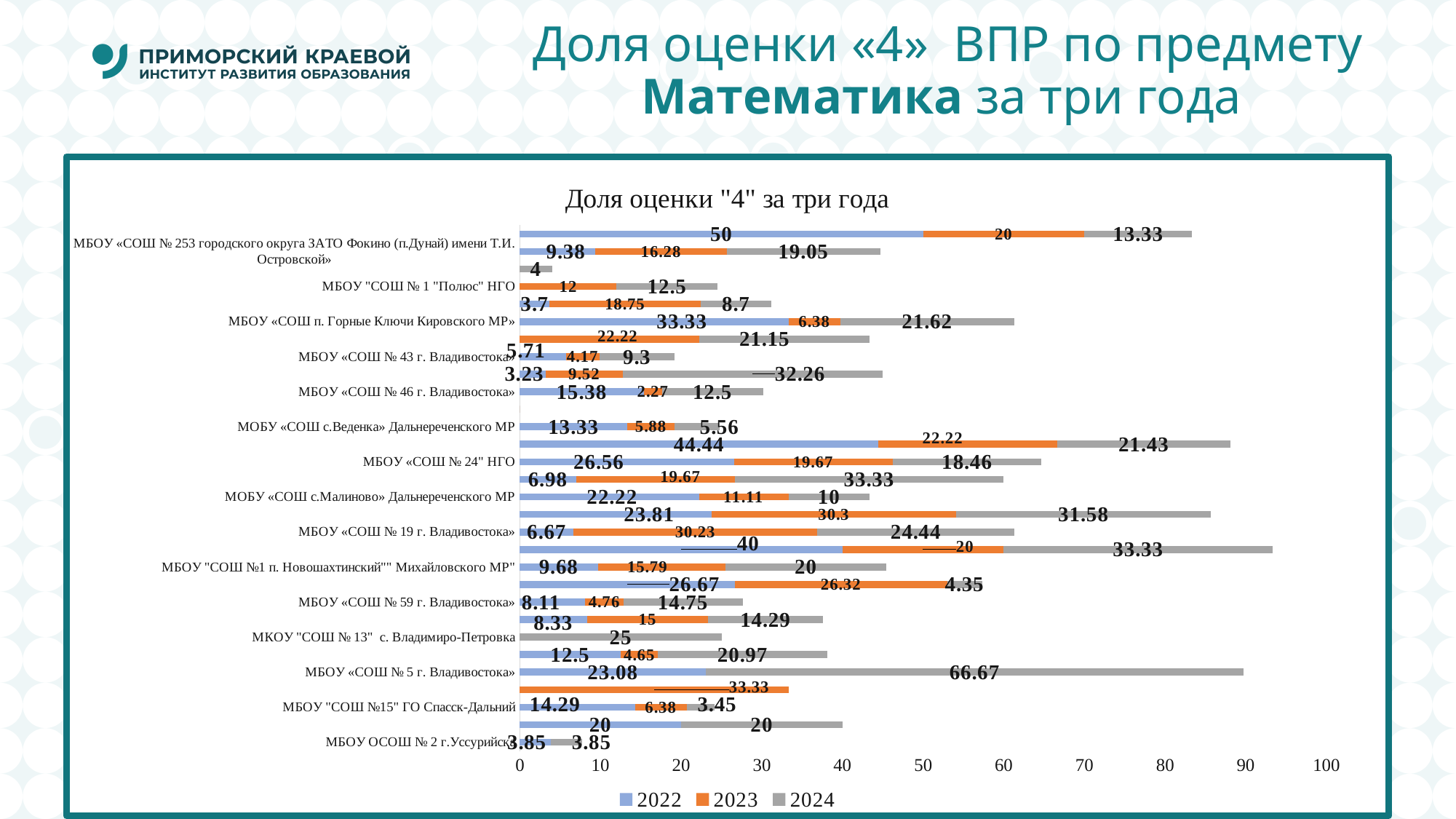
What is the 2024 value for МБОУ «СОШ № 5 г. Владивостока»? 66.67 What is the 2022 value for МБОУ «СОШ п. Горные Ключи Кировского МР»? 33.33 What is the 2022 value for МБОУ «СОШ № 46 г. Владивостока»? 15.38 What is the difference between the 2022 and 2024 values for МБОУ «СОШ № 46 г. Владивостока»? 2.88 For МБОУ «СОШ № 5 г. Владивостока», which year has the larger value, 2022 or 2024? 2024 What is the title of the chart? Доля оценки "4" за три года How many series does the legend list? 3 What is the total of the stacked bar for МБОУ ОСОШ № 2 г.Уссурийска? 7.7 What is the 2023 value for МБОУ «СОШ № 19 г. Владивостока»? 30.23 What kind of chart is shown on the slide? Stacked horizontal bar chart Which colour represents the 2023 series in the chart? Orange What is the 2024 value for МКОУ "СОШ № 13" с. Владимиро-Петровка? 25